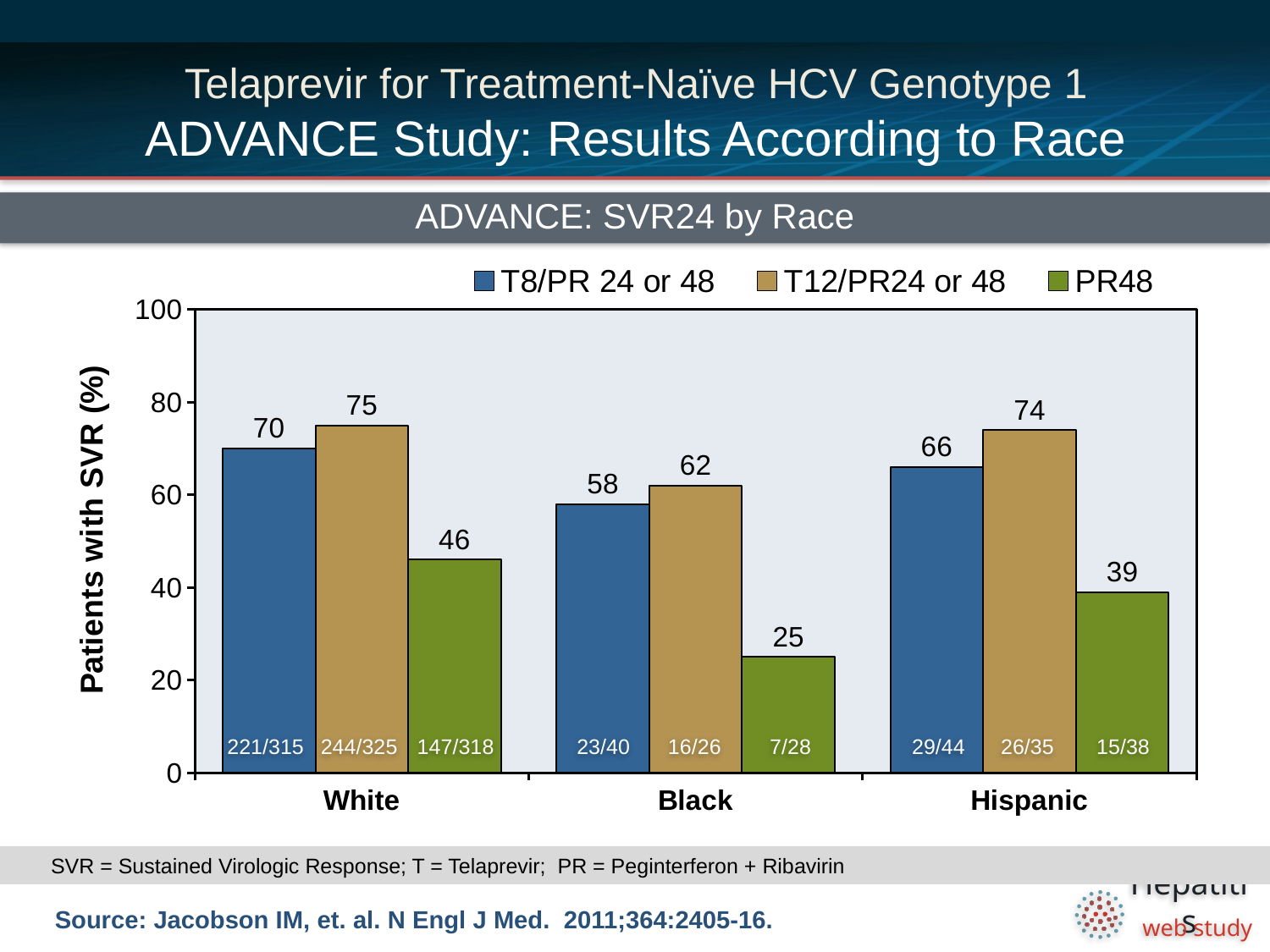
What is the chart's title? ADVANCE: SVR24 by Race How many series does the legend list? 3 What is the SVR rate for the T12/PR24 or 48 group among Hispanic patients? 74 Which race category has the lowest SVR rate for the T12/PR24 or 48 group? Black What kind of chart is shown on the slide? Bar chart What is the SVR rate for the PR48 group among Black patients? 25 Which is larger among Hispanic patients: the SVR rate for T8/PR 24 or 48 or for PR48? T8/PR 24 or 48 Which race category has the highest SVR rate for the PR48 group? White What is the SVR rate for the T8/PR 24 or 48 group among White patients? 70 How many race categories are shown on the x axis? 3 What is the label of the y axis? Patients with SVR (%) What is the difference between the T12/PR24 or 48 and PR48 SVR rates among Black patients? 37